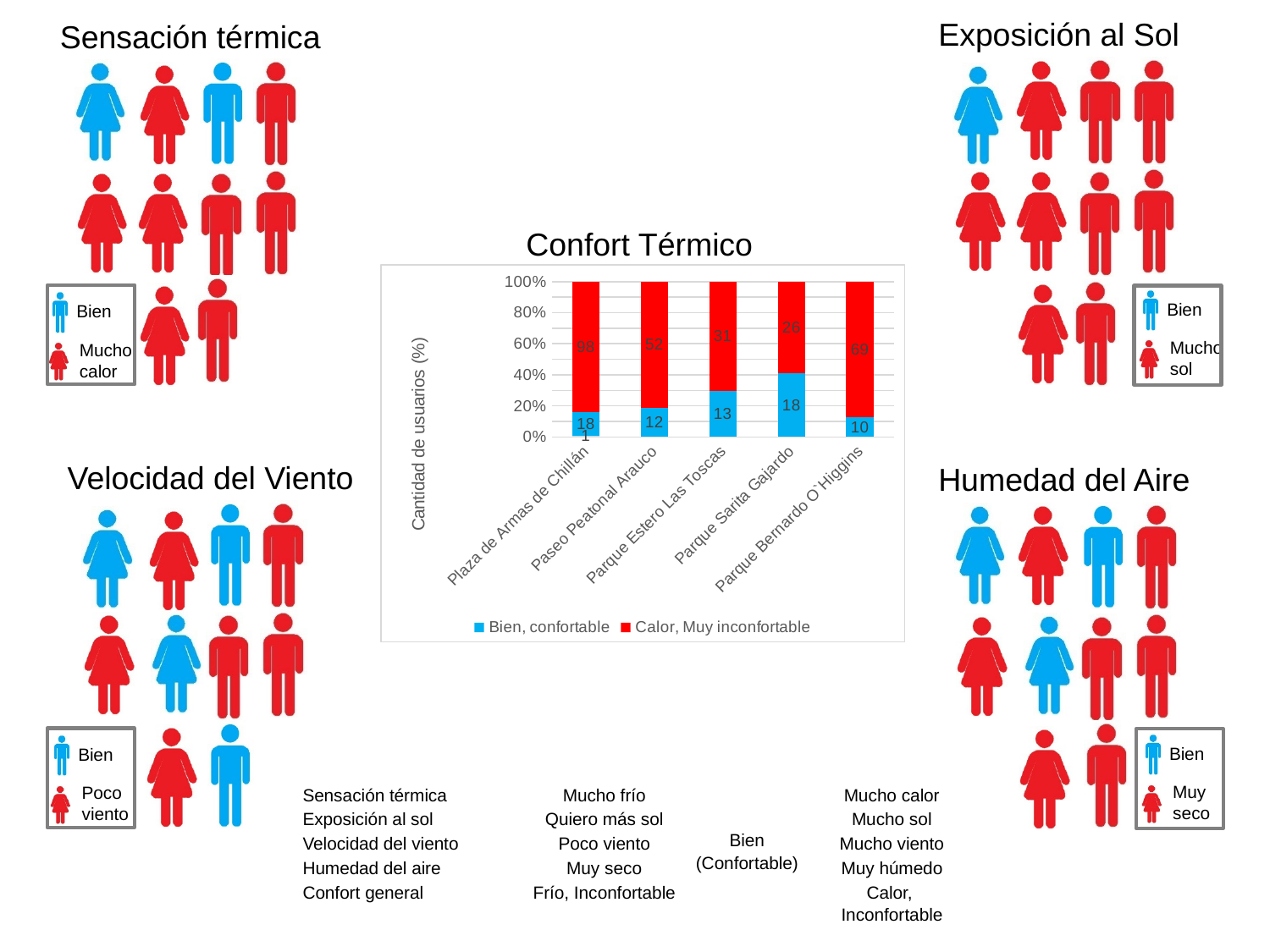
What is the y-axis title of the Confort Térmico chart? Cantidad de usuarios (%) In the Confort Térmico chart, what is the data label for 'Bien, confortable' at Parque Estero Las Toscas? 13 In the Confort Térmico chart, which location has the highest 'Calor, Muy inconfortable' data label? Plaza de Armas de Chillán How many locations are shown on the x axis of the Confort Térmico chart? 5 In the Confort Térmico chart, what is the data label for 'Bien, confortable' at Parque Bernardo O`Higgins? 10 What kind of chart is the Confort Térmico chart? stacked bar chart In the Confort Térmico chart, what is the data label for 'Calor, Muy inconfortable' at Paseo Peatonal Arauco? 52 In the Confort Térmico chart, which location has the lowest 'Bien, confortable' data label? Parque Bernardo O`Higgins In the Confort Térmico chart, is the 'Bien, confortable' share of the bar for Parque Sarita Gajardo greater or less than 20%? greater In the Confort Térmico chart, which is larger: the 'Calor, Muy inconfortable' label at Paseo Peatonal Arauco or at Parque Estero Las Toscas? Paseo Peatonal Arauco In the Confort Térmico chart, what is the difference between the 'Calor, Muy inconfortable' and 'Bien, confortable' data labels at Parque Sarita Gajardo? 8 How many series does the legend of the Confort Térmico chart list? 2